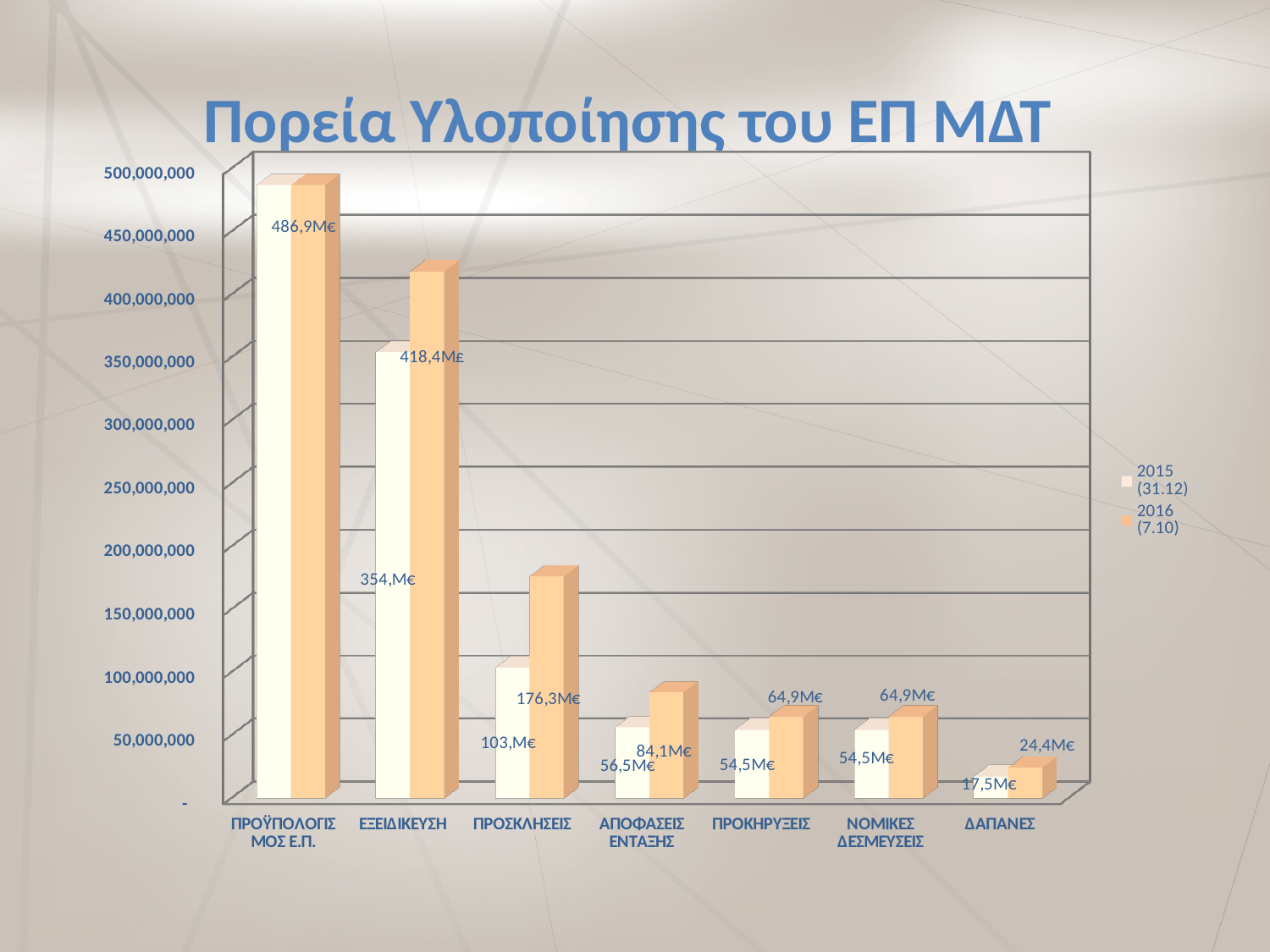
What is the 2015 (31.12) value for ΑΠΟΦΑΣΕΙΣ ΕΝΤΑΞΗΣ? 56,5M€ Which category has the lowest values in the chart? ΔΑΠΑΝΕΣ What is the 2015 (31.12) value for ΠΡΟΣΚΛΗΣΕΙΣ? 103,M€ Which category has the highest values in the chart? ΠΡΟΫΠΟΛΟΓΙΣΜΟΣ Ε.Π. What is the 2016 (7.10) value for ΔΑΠΑΝΕΣ? 24,4M€ What kind of chart is shown on the slide? Bar chart How many categories are shown on the x axis? 7 How many series does the legend list? 2 What is the 2016 (7.10) value for ΕΞΕΙΔΙΚΕΥΣΗ? 418,4M€ Which is larger for ΑΠΟΦΑΣΕΙΣ ΕΝΤΑΞΗΣ: the 2015 (31.12) value or the 2016 (7.10) value? 2016 (7.10) What is the title of the chart? Πορεία Υλοποίησης του ΕΠ ΜΔΤ